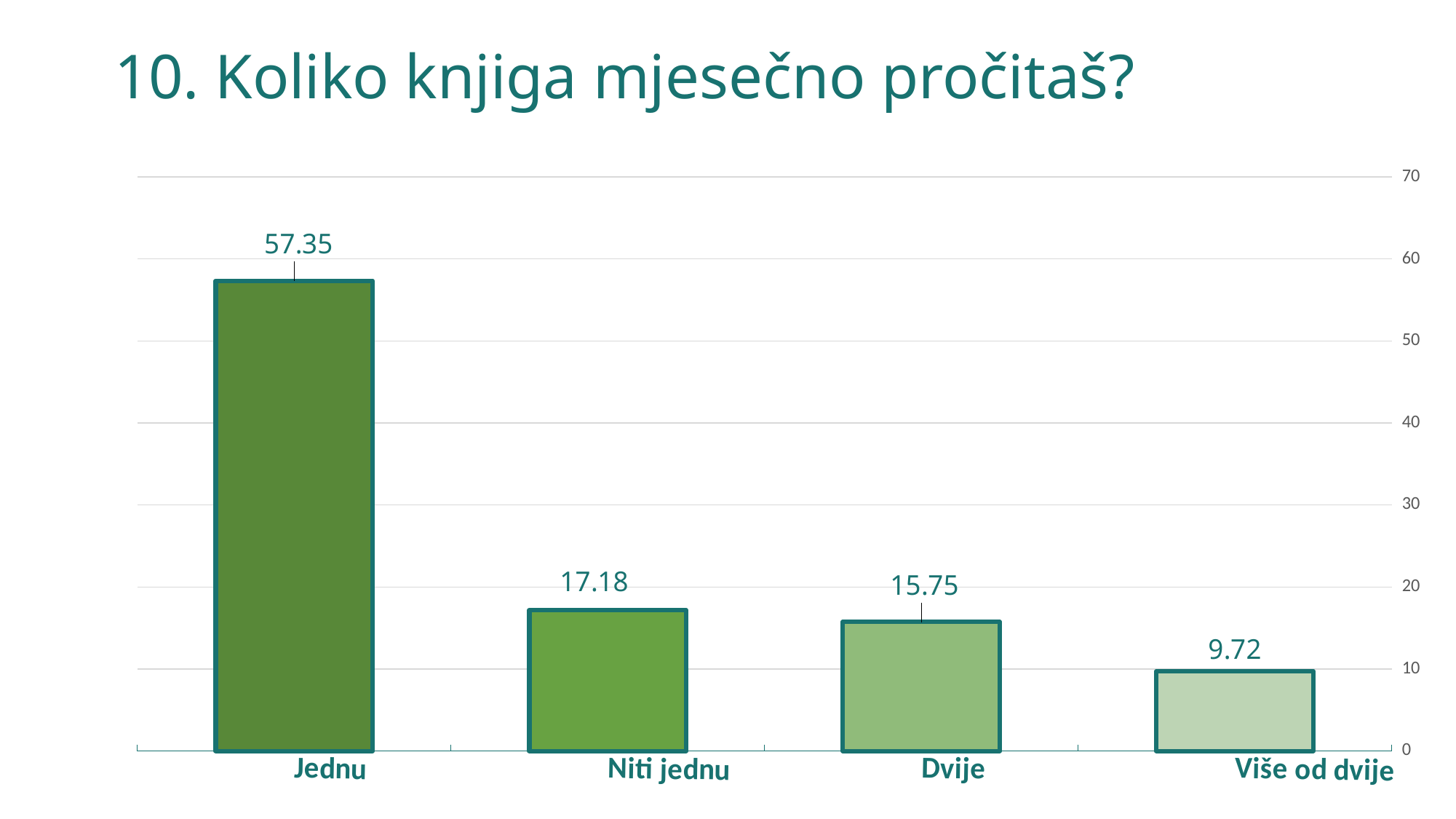
What kind of chart is shown on the slide? bar chart What is the value for Dvije? 15.75 Which is larger, the value for Niti jednu or the value for Dvije? Niti jednu Is the value for Jednu greater or less than 50? greater What is the difference between the values for Jednu and Niti jednu? 40.17 What is the value for Više od dvije? 9.72 Which category has the highest value? Jednu What is the value for Niti jednu? 17.18 What is the difference between the values for Dvije and Više od dvije? 6.03 How many categories are shown on the x axis? 4 What is the value for Jednu? 57.35 Which category has the lowest value? Više od dvije